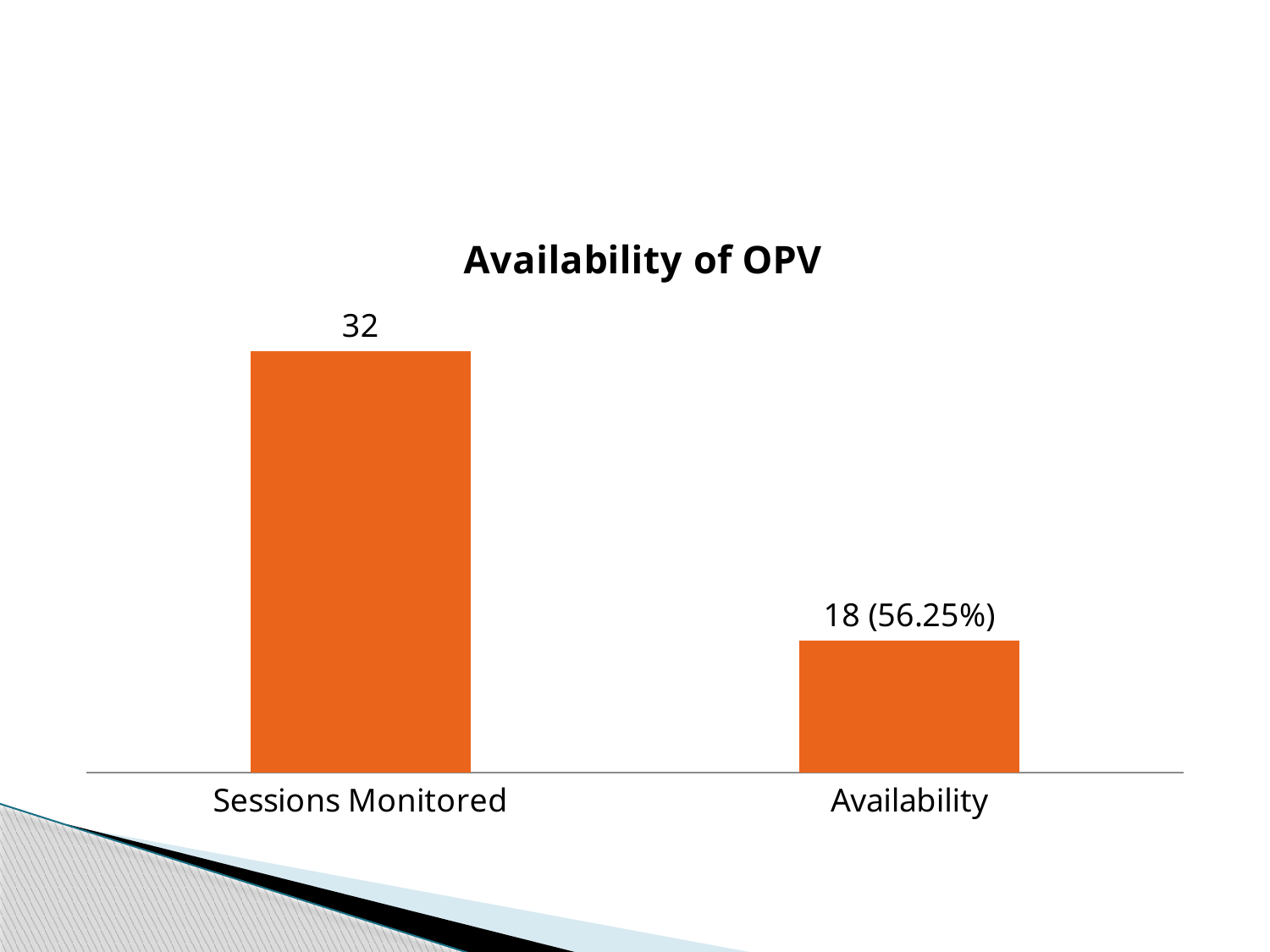
What kind of chart is this? Bar chart Which is larger, Sessions Monitored or Availability? Sessions Monitored What colour are the bars in the chart? Orange Which category has the lowest value? Availability Which category has the highest value? Sessions Monitored How many categories are shown in the chart? 2 What is the title of the chart? Availability of OPV What is the difference between Sessions Monitored and Availability? 14 What is the data label shown on the Availability bar? 18 (56.25%) What is the value for Sessions Monitored? 32 What percentage is shown in the Availability data label? 56.25%